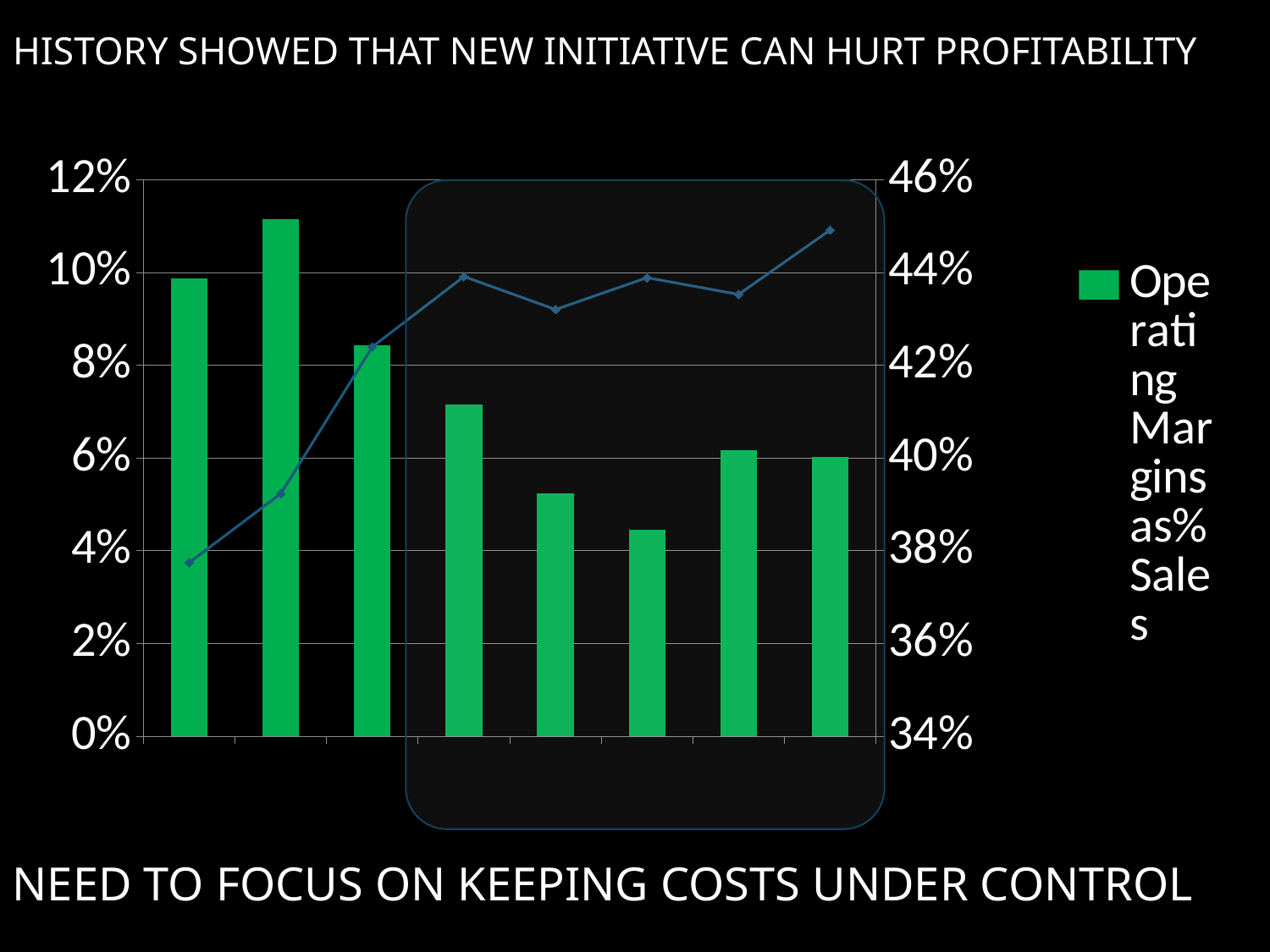
Is the value of the sixth bar from the left greater or less than 6%? less What series name does the legend show for the green bars? Operating Margins as% Sales Is the value of the second bar from the left greater or less than 10%? greater What kind of chart is shown on the slide? A bar chart combined with a line Which is larger, the fourth bar or the fifth bar from the left? The fourth bar Is the last point of the line series greater or less than 44% on the right axis? greater Does the line series generally rise or fall from left to right? rise Which bar, counting from the left, is the tallest? The second bar How many series does the legend list? 1 Which bar, counting from the left, is the shortest? The sixth bar How many green bars are plotted in the chart? 8